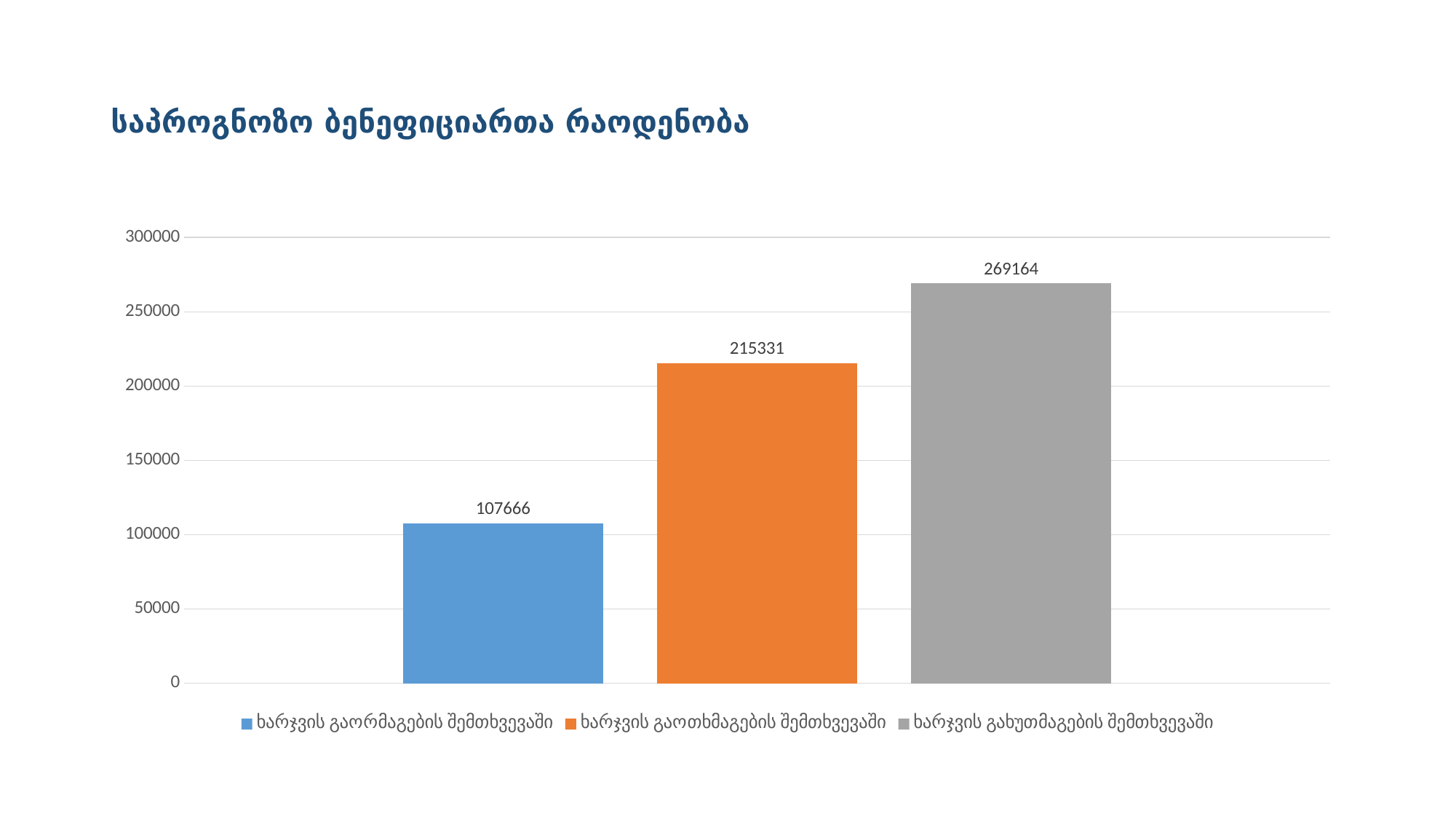
Which is larger: the value for ხარჯვის გაოთხმაგების შემთხვევაში or for ხარჯვის გახუთმაგების შემთხვევაში? ხარჯვის გახუთმაგების შემთხვევაში Which series has the lowest value? ხარჯვის გაორმაგების შემთხვევაში What is the difference between the values for ხარჯვის გახუთმაგების შემთხვევაში and ხარჯვის გაოთხმაგების შემთხვევაში? 53833 What is the title of the chart? საპროგნოზო ბენეფიციართა რაოდენობა What is the value for ხარჯვის გაორმაგების შემთხვევაში? 107666 Which series has the highest value? ხარჯვის გახუთმაგების შემთხვევაში What kind of chart is shown on the slide? bar chart Is the value for ხარჯვის გაორმაგების შემთხვევაში greater or less than 150000? less How many series does the legend list? 3 What is the value for ხარჯვის გაოთხმაგების შემთხვევაში? 215331 What is the value for ხარჯვის გახუთმაგების შემთხვევაში? 269164 What is the difference between the values for ხარჯვის გაოთხმაგების შემთხვევაში and ხარჯვის გაორმაგების შემთხვევაში? 107665